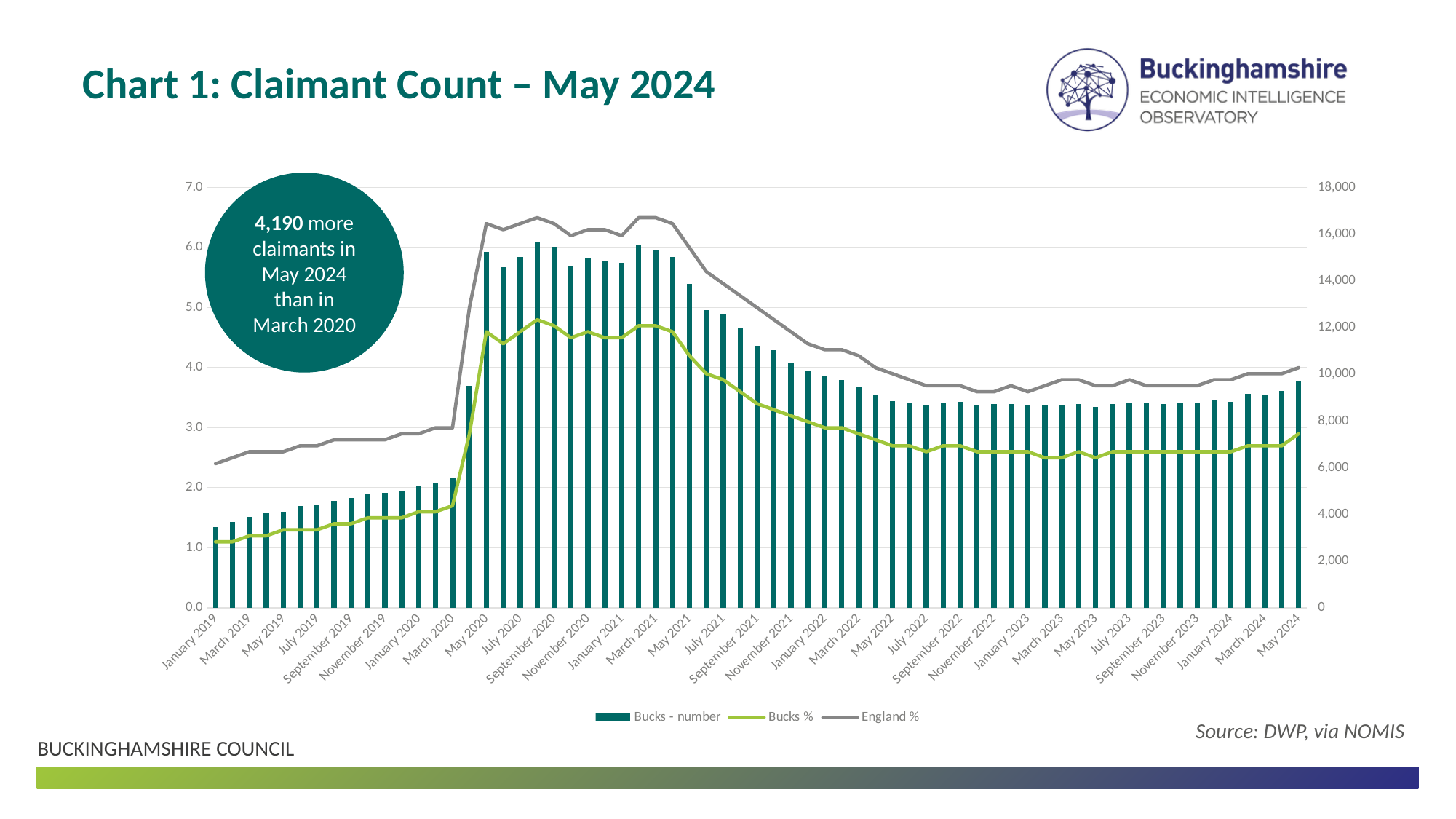
Is the Bucks - number value for May 2024 greater or less than 8,000? greater According to the callout, how many more claimants were there in May 2024 than in March 2020? 4,190 Is the Bucks % value for January 2019 greater or less than 2.0? less Is the England % value for May 2024 greater or less than 3.0? greater In May 2024, which is higher: Bucks % or England %? England % What kind of chart is this? Combined bar and line chart How many series does the legend list? 3 Which month has the lowest Bucks - number value? January 2019 Do the Bucks - number bars rise or fall from March 2021 to July 2022? fall Which series is plotted as bars? Bucks - number